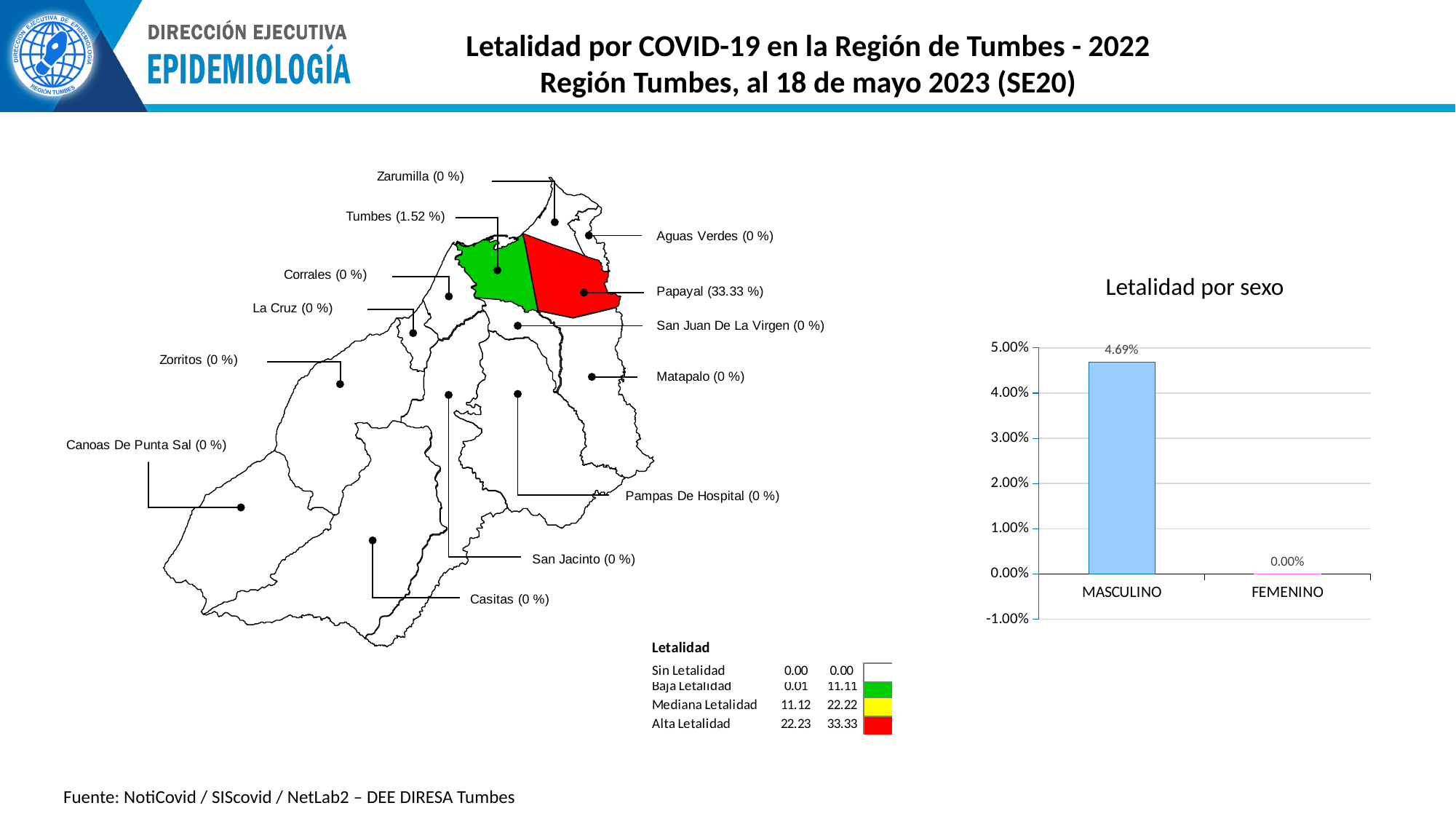
In the 'Letalidad por sexo' chart, what is the value for MASCULINO? 4.69% How many categories are shown in the 'Letalidad por sexo' chart? 2 In the 'Letalidad por sexo' chart, is the value for MASCULINO greater or less than 4.00%? greater On the map on the left, what is the lethality value shown for Tumbes? 1.52 % On the map on the left, what is the lethality value shown for Papayal? 33.33 % In the 'Letalidad por sexo' chart, what is the value for FEMENINO? 0.00% What kind of chart is 'Letalidad por sexo'? bar chart On the map on the left, which district has the highest lethality value? Papayal On the map on the left, what colour is used for 'Alta Letalidad' in the legend? red In the 'Letalidad por sexo' chart, what is the difference between the MASCULINO and FEMENINO values? 4.69% In the 'Letalidad por sexo' chart, which category has the lowest value? FEMENINO In the 'Letalidad por sexo' chart, which category has the highest value? MASCULINO